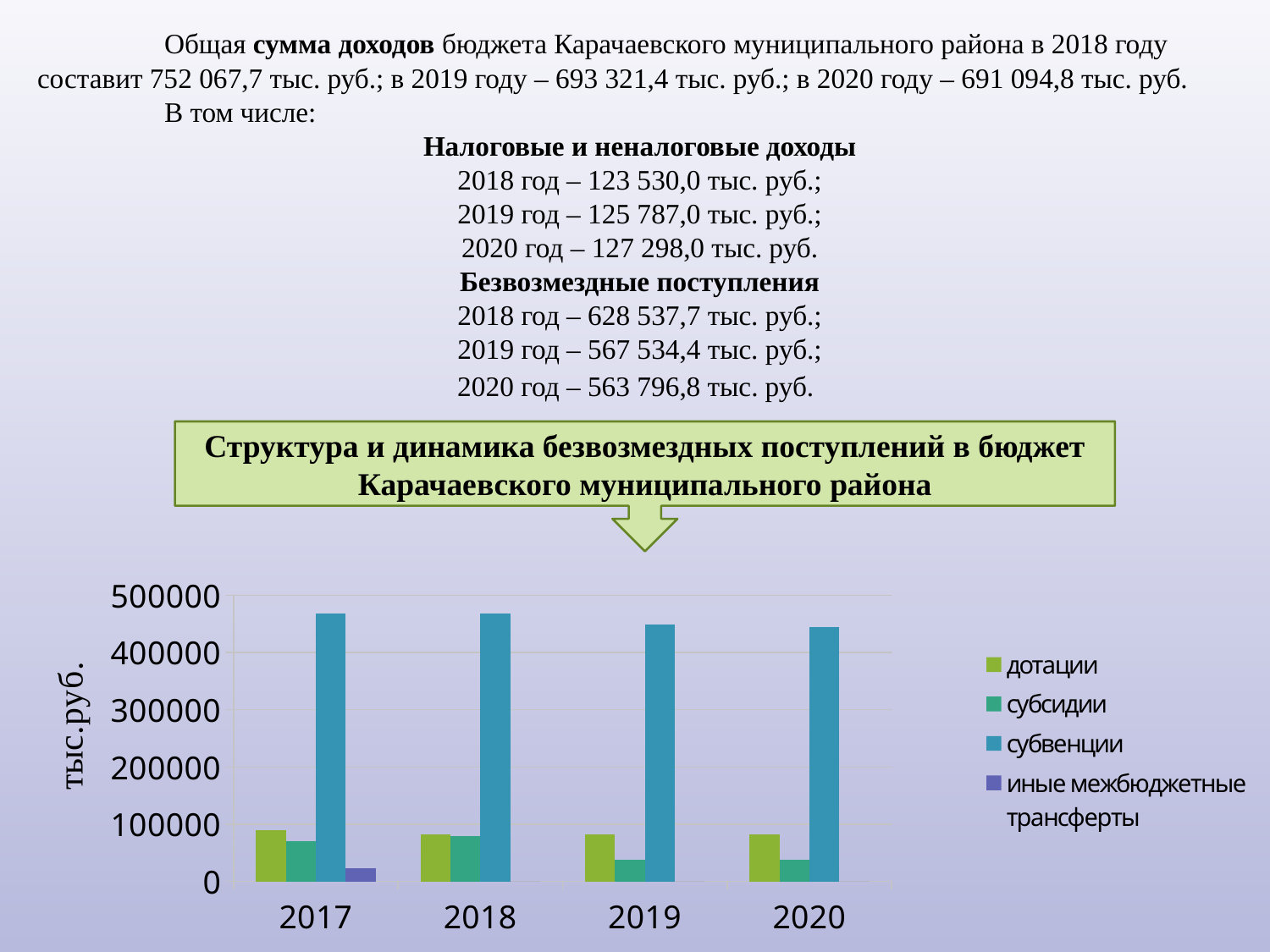
How many series does the chart legend list? 4 Is the value for субвенции in 2018 greater or less than 400000? greater What is the label on the vertical axis of the chart? тыс.руб. What kind of chart is shown on the slide? bar chart Which series has the highest value in 2017? субвенции Do the values for субвенции rise or fall from 2018 to 2020? fall Is the value for дотации in 2019 greater or less than 100000? less Which series has the lowest value in 2017? иные межбюджетные трансферты Which is larger in 2019: дотации or субсидии? дотации How many years are shown on the x axis of the chart? 4 Which series is shown in blue in the chart legend? субвенции Is the value for субсидии in 2020 greater or less than 100000? less